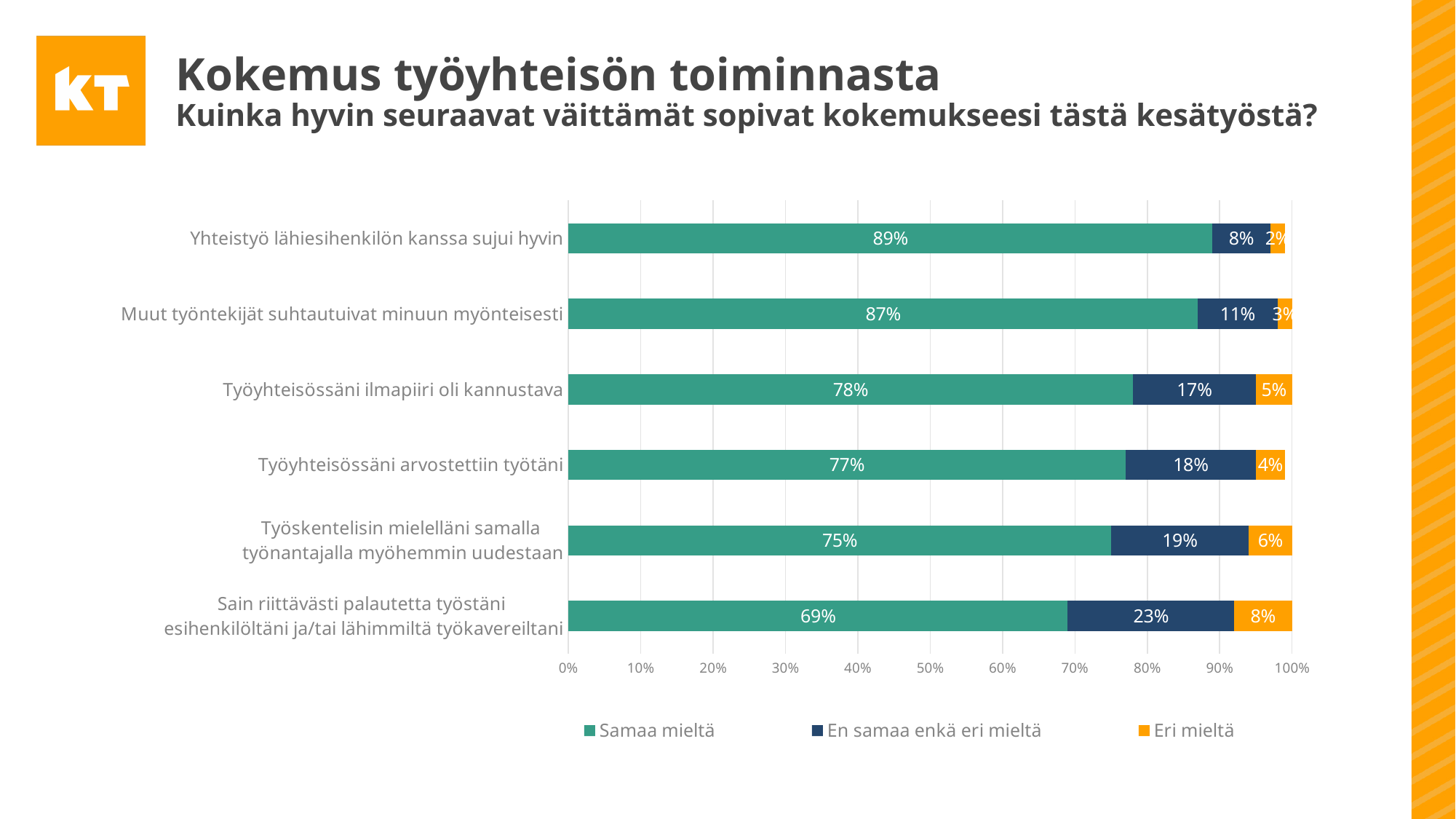
What kind of chart is shown on the slide? Stacked bar chart Which statement has the lowest "Samaa mieltä" share? Sain riittävästi palautetta työstäni esihenkilöltäni ja/tai lähimmiltä työkavereiltani What is the "En samaa enkä eri mieltä" value for "Työskentelisin mielelläni samalla työnantajalla myöhemmin uudestaan"? 19% Which legend entry is shown in orange? Eri mieltä How many series does the legend list? 3 What is the difference in "Samaa mieltä" between "Muut työntekijät suhtautuivat minuun myönteisesti" and "Työyhteisössäni ilmapiiri oli kannustava"? 9 percentage points Which statement has the highest "Samaa mieltä" share? Yhteistyö lähiesihenkilön kanssa sujui hyvin What percentage of respondents answered "Samaa mieltä" for "Yhteistyö lähiesihenkilön kanssa sujui hyvin"? 89% What is the "Eri mieltä" value for "Sain riittävästi palautetta työstäni esihenkilöltäni ja/tai lähimmiltä työkavereiltani"? 8% What is the total of the three segments for "Työyhteisössäni ilmapiiri oli kannustava"? 100% Which has a larger "Eri mieltä" share: "Työyhteisössäni ilmapiiri oli kannustava" or "Työyhteisössäni arvostettiin työtäni"? Työyhteisössäni ilmapiiri oli kannustava How many statements (categories) are shown in the chart? 6